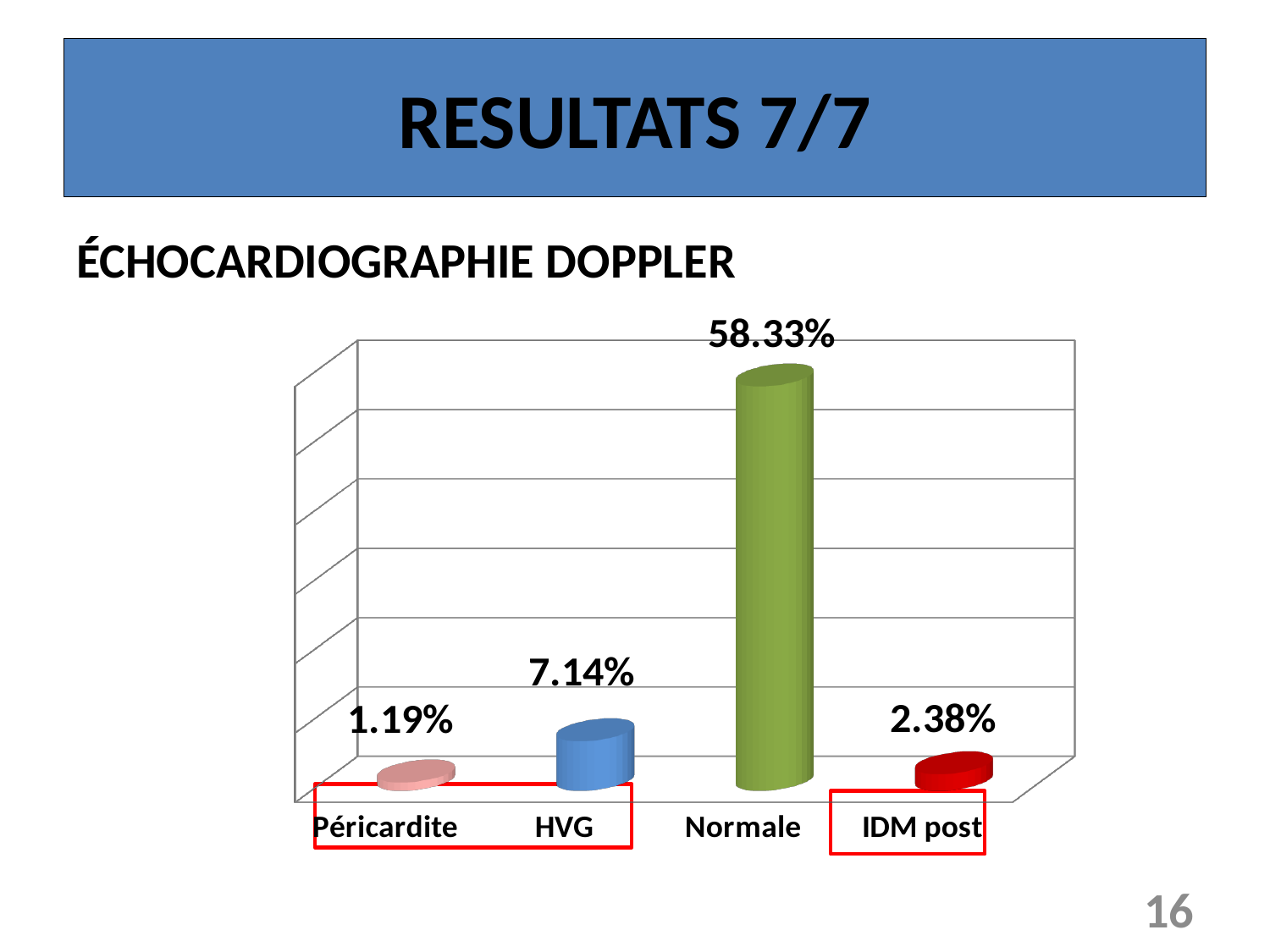
Which is larger, the value for HVG or the value for IDM post? HVG What is the heading above the chart? ÉCHOCARDIOGRAPHIE DOPPLER How many categories are shown in the chart? 4 Which category has the lowest value? Péricardite What kind of chart is shown on the slide? Bar chart What is the difference between the values for IDM post and Péricardite? 1.19% What is the value for HVG? 7.14% What is the value for IDM post? 2.38% What is the difference between the values for Normale and HVG? 51.19% What is the value for Péricardite? 1.19% What is the value for Normale? 58.33% Which category has the highest value? Normale